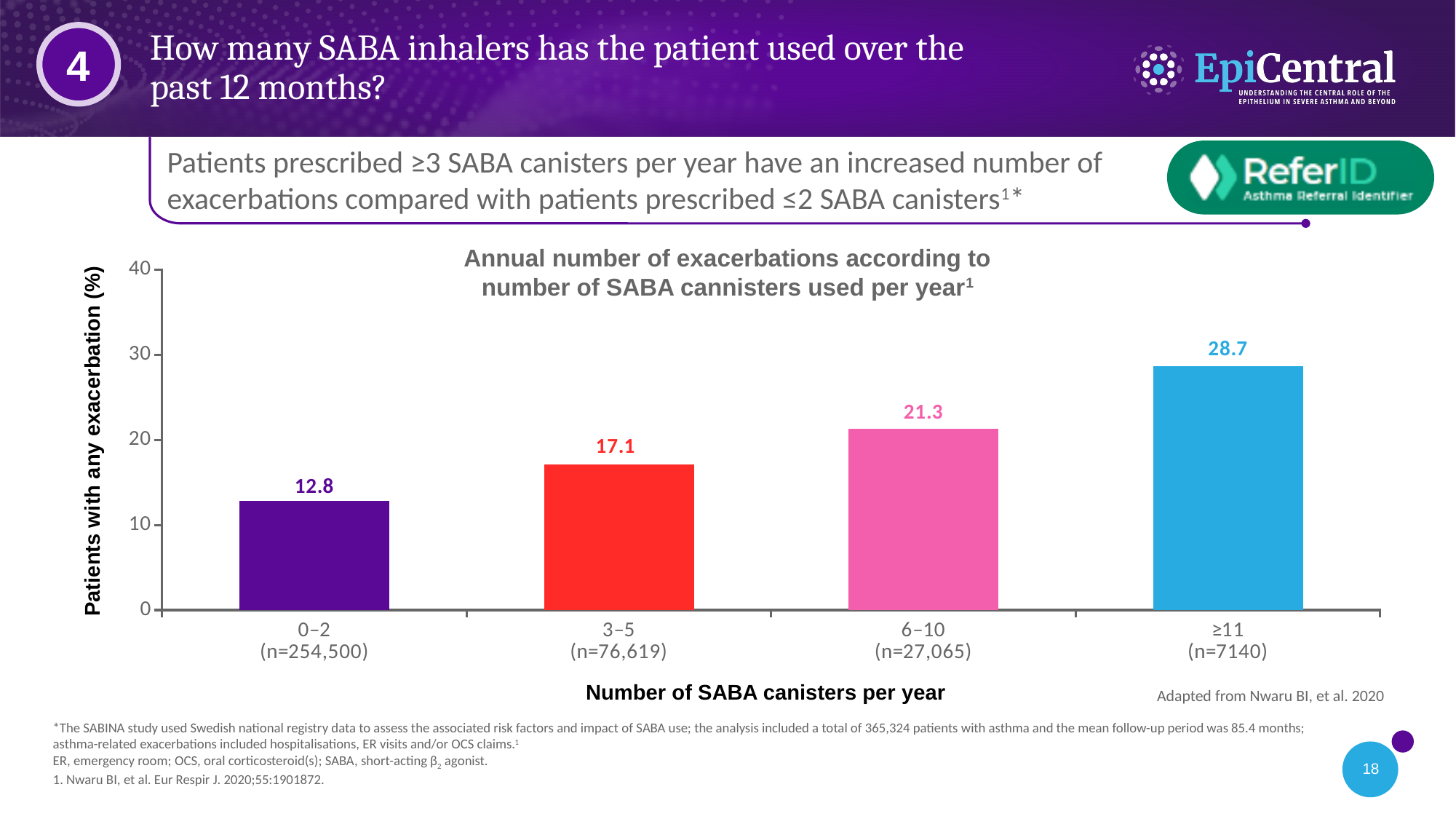
Which group has a higher value: 3–5 canisters or 6–10 canisters? 6–10 What kind of chart is shown on the slide? Bar chart What is the value shown for the 6–10 SABA canisters per year group? 21.3 How many SABA canister categories are shown on the x axis? 4 What percentage of patients with 0–2 SABA canisters per year had any exacerbation? 12.8 Which SABA canister group has the highest percentage of patients with any exacerbation? ≥11 Which SABA canister group has the lowest percentage of patients with any exacerbation? 0–2 What is the difference in percentage points between the ≥11 group and the 0–2 group? 15.9 Is the value for the ≥11 group greater or less than 30? less What is the value shown for the ≥11 SABA canisters per year group? 28.7 Do the values rise or fall as the number of SABA canisters per year increases? Rise What is the value shown for the 3–5 SABA canisters per year group? 17.1